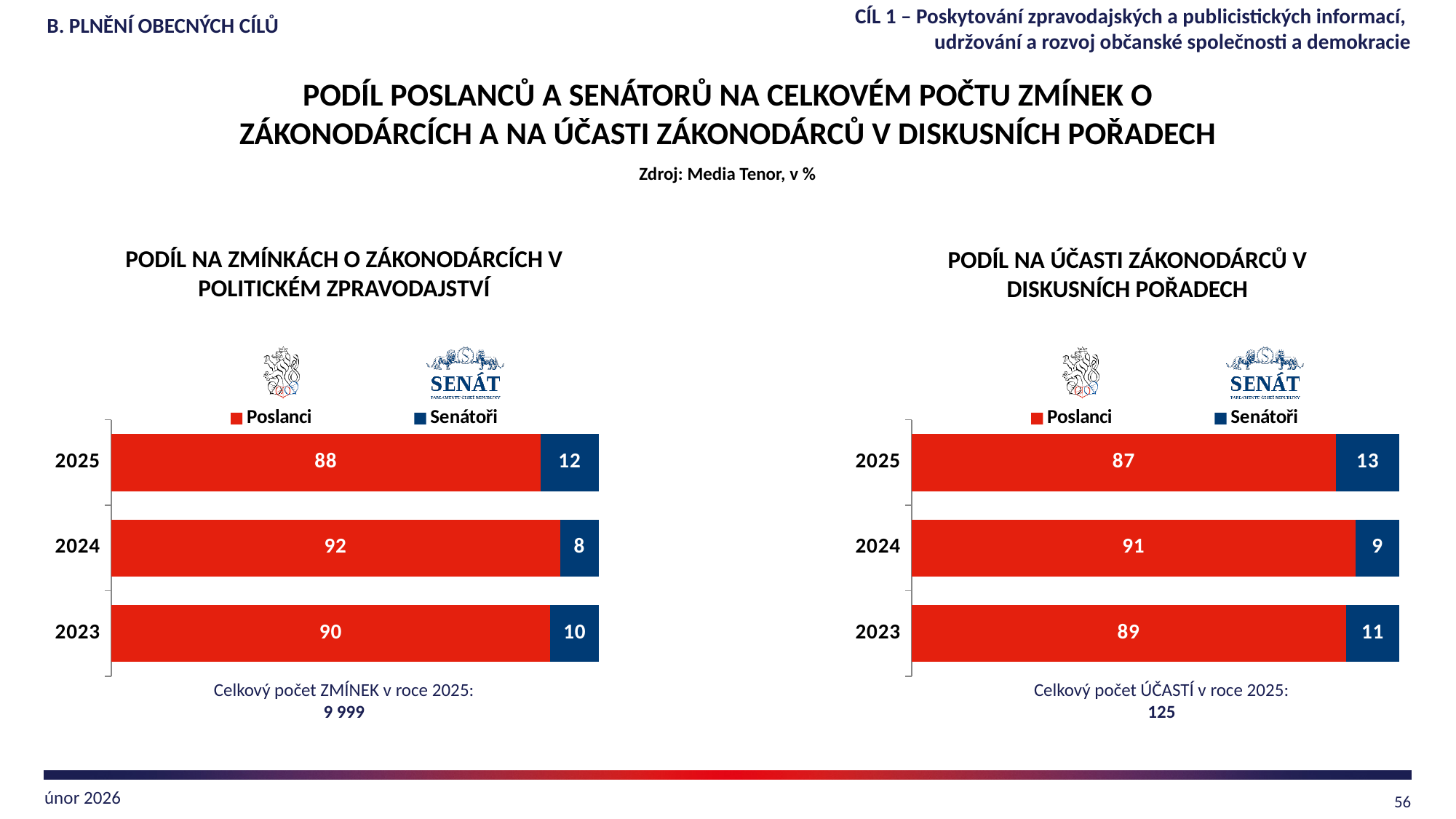
In the right chart (Podíl na účasti zákonodárců v diskusních pořadech), is the Poslanci value larger in 2024 or in 2025? 2024 In the left chart (Podíl na zmínkách o zákonodárcích v politickém zpravodajství), which year has the highest value for Senátoři? 2025 In the right chart (Podíl na účasti zákonodárců v diskusních pořadech), what is the value for Poslanci in 2023? 89 In the left chart (Podíl na zmínkách o zákonodárcích v politickém zpravodajství), what is the value for Senátoři in 2024? 8 How many years are shown in the left chart (Podíl na zmínkách o zákonodárcích v politickém zpravodajství)? 3 In the left chart (Podíl na zmínkách o zákonodárcích v politickém zpravodajství), what is the difference between the Poslanci and Senátoři values in 2023? 80 In the right chart (Podíl na účasti zákonodárců v diskusních pořadech), which year has the lowest value for Senátoři? 2024 In the left chart (Podíl na zmínkách o zákonodárcích v politickém zpravodajství), what is the value for Poslanci in 2025? 88 In the right chart (Podíl na účasti zákonodárců v diskusních pořadech), what is the value for Senátoři in 2025? 13 What kind of chart is the left chart (Podíl na zmínkách o zákonodárcích v politickém zpravodajství)? Stacked bar chart In the right chart (Podíl na účasti zákonodárců v diskusních pořadech), what is the total of the stacked bar for 2025? 100 How many series does the legend of the right chart (Podíl na účasti zákonodárců v diskusních pořadech) list? 2